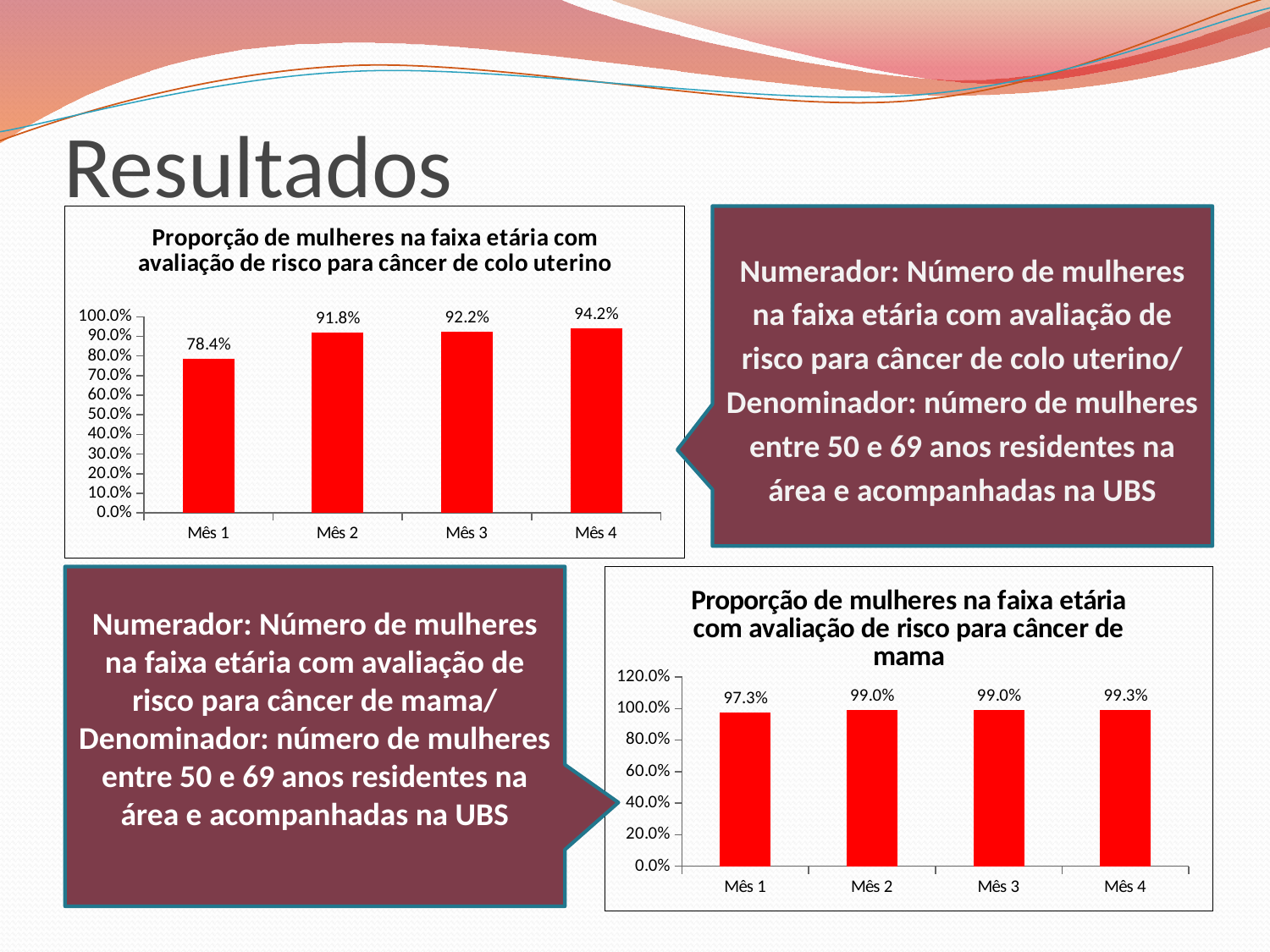
In the top-left chart (câncer de colo uterino), what is the difference between Mês 2 and Mês 1? 13.4% In the bottom-right chart (câncer de mama), what is the value for Mês 4? 99.3% In the top-left chart (câncer de colo uterino), which month has the highest value? Mês 4 In the bottom-right chart (câncer de mama), what is the difference between Mês 4 and Mês 1? 2.0% In the top-left chart (câncer de colo uterino), what is the value for Mês 1? 78.4% In the top-left chart (câncer de colo uterino), which month has the lowest value? Mês 1 In the top-left chart (câncer de colo uterino), do the values rise or fall from Mês 1 to Mês 4? rise In the bottom-right chart (câncer de mama), what is the value for Mês 1? 97.3% In the top-left chart (câncer de colo uterino), what is the value for Mês 4? 94.2% How many bars are shown in the bottom-right chart (câncer de mama)? 4 What type of chart is the top-left chart (câncer de colo uterino)? bar chart In the bottom-right chart (câncer de mama), which month has the lowest value? Mês 1